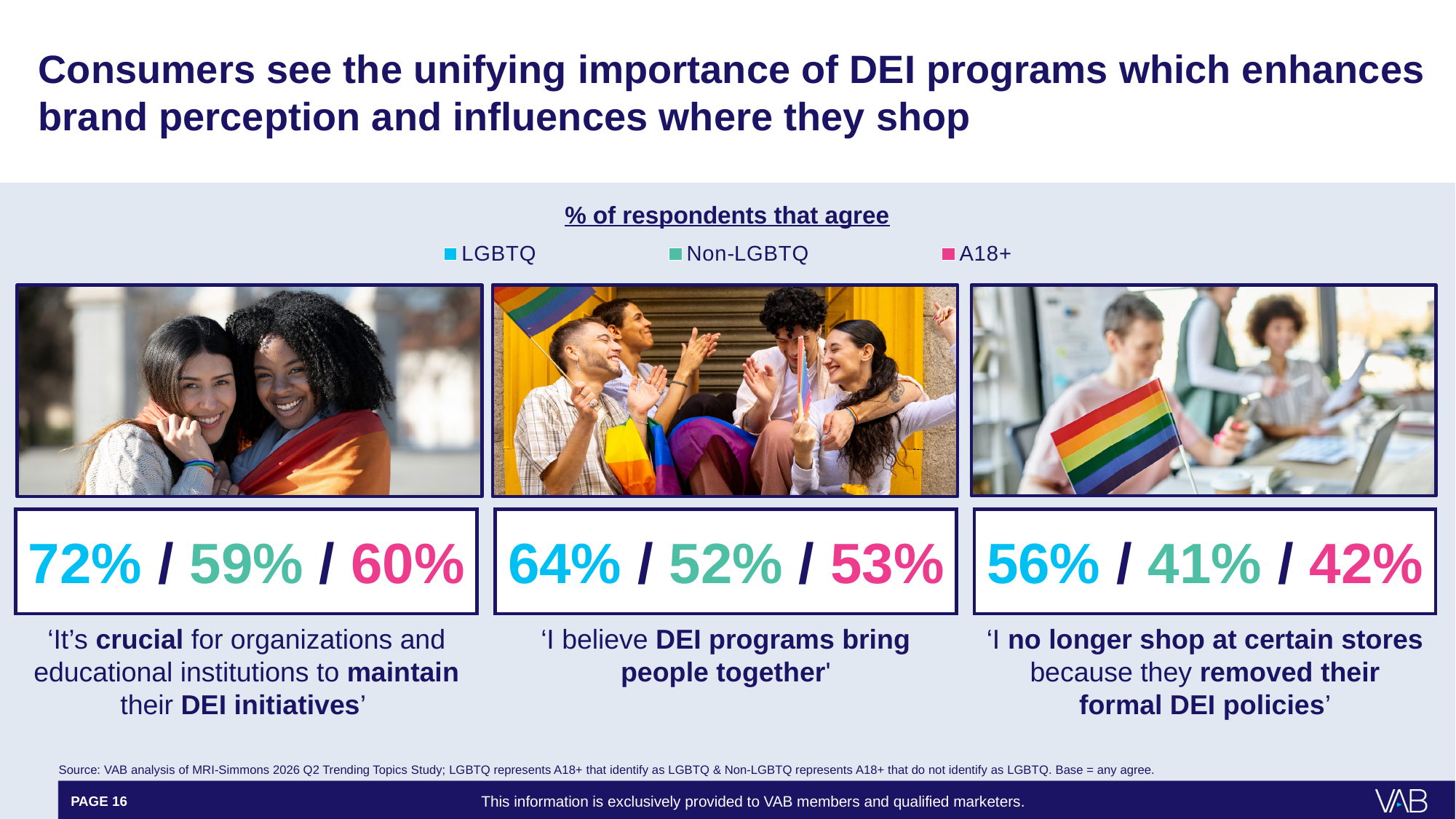
For the statement 'I no longer shop at certain stores because they removed their formal DEI policies', which group has a higher share agreeing: LGBTQ or Non-LGBTQ? LGBTQ Which statement has the lowest share of Non-LGBTQ respondents agreeing? 'I no longer shop at certain stores because they removed their formal DEI policies' What percentage of LGBTQ respondents agree that 'I no longer shop at certain stores because they removed their formal DEI policies'? 56% What is the title above the legend describing the figures shown? % of respondents that agree What percentage of LGBTQ respondents agree that 'It's crucial for organizations and educational institutions to maintain their DEI initiatives'? 72% What is the difference in percentage points between LGBTQ and A18+ respondents agreeing that 'It's crucial for organizations and educational institutions to maintain their DEI initiatives'? 12 Which statement has the highest share of LGBTQ respondents agreeing? 'It's crucial for organizations and educational institutions to maintain their DEI initiatives' What percentage of A18+ respondents agree that 'I no longer shop at certain stores because they removed their formal DEI policies'? 42% How many statements are shown with agreement percentages? 3 What percentage of Non-LGBTQ respondents agree that 'I believe DEI programs bring people together'? 52% What is the difference in percentage points between LGBTQ and Non-LGBTQ respondents agreeing that 'I believe DEI programs bring people together'? 12 How many respondent groups does the legend list? 3